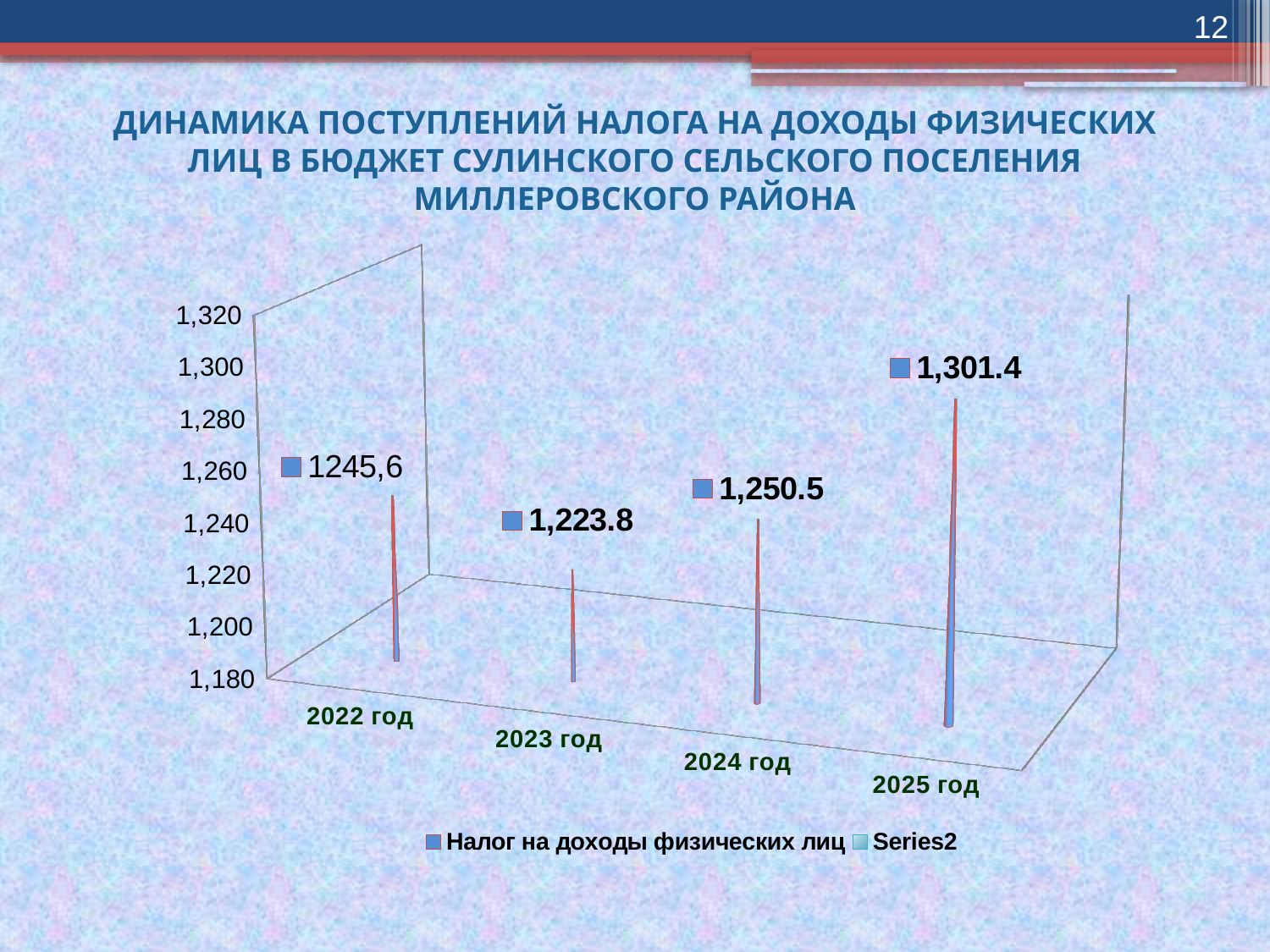
How many series does the legend list? 2 What is the difference between the values for 2025 год and 2024 год? 50.9 What is the value shown for 2023 год? 1,223.8 Which year has the highest value? 2025 год What is the value shown for 2022 год? 1245,6 What kind of chart is shown on the slide? bar chart What is the value shown for 2024 год? 1,250.5 Which is larger, the value for 2022 год or the value for 2023 год? 2022 год How many years are shown on the x axis? 4 What is the value shown for 2025 год? 1,301.4 What is the difference between the values for 2024 год and 2023 год? 26.7 Which year has the lowest value? 2023 год